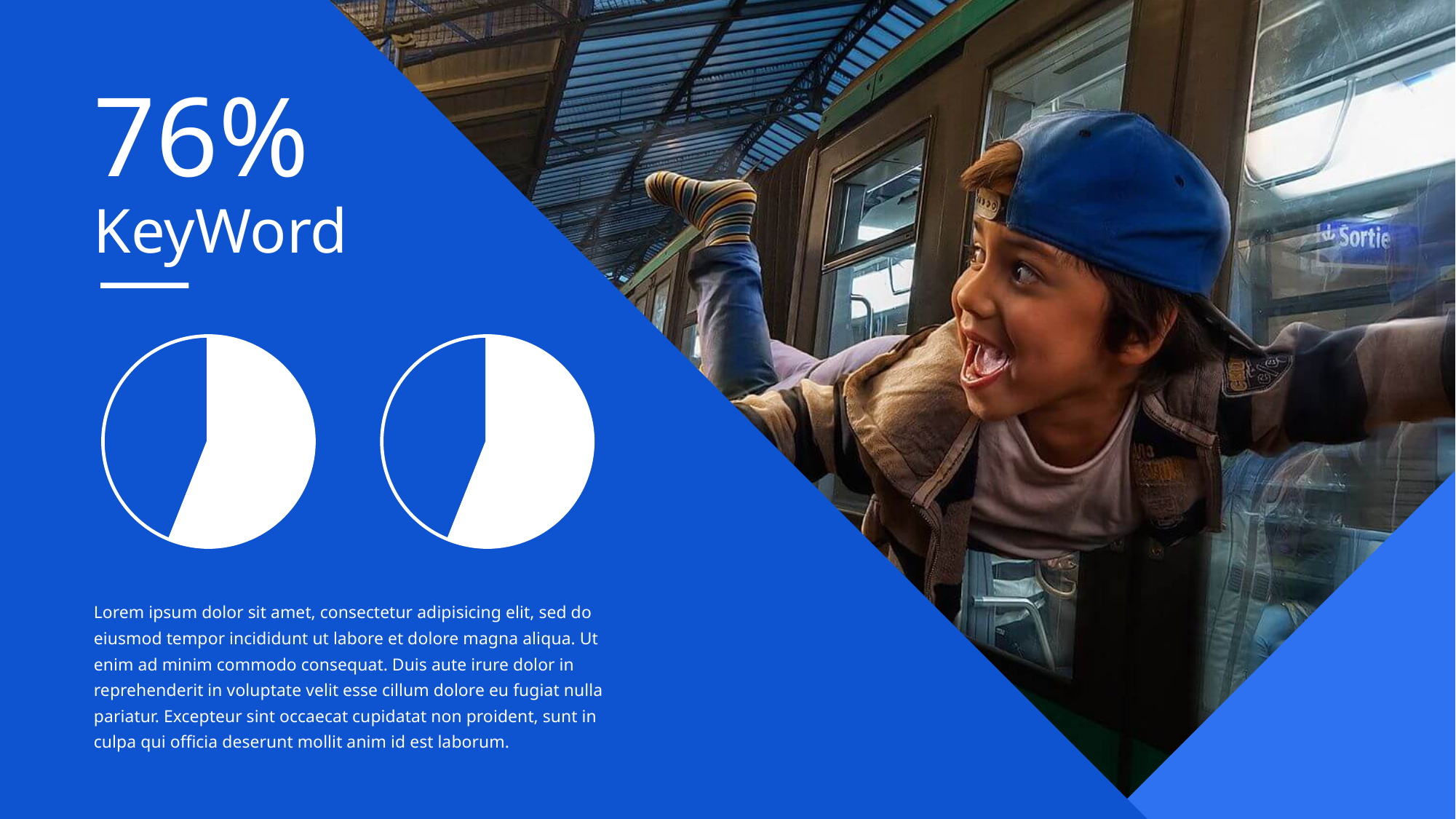
What two colours are used for the slices in the pie charts? white and blue What kind of chart is the left chart on the slide? pie chart What kind of chart is the right chart on the slide? pie chart In the left pie chart, which slice is larger, the white slice or the blue slice? the white slice Do the pie charts on the slide have a legend? No How many slices does the left pie chart have? 2 How many slices does the right pie chart have? 2 Is the blue slice of the right pie chart greater or less than 50% of the pie? less In the right pie chart, which slice is larger, the white slice or the blue slice? the white slice Is the white slice of the left pie chart greater or less than 50% of the pie? greater How many pie charts are shown on the slide? 2